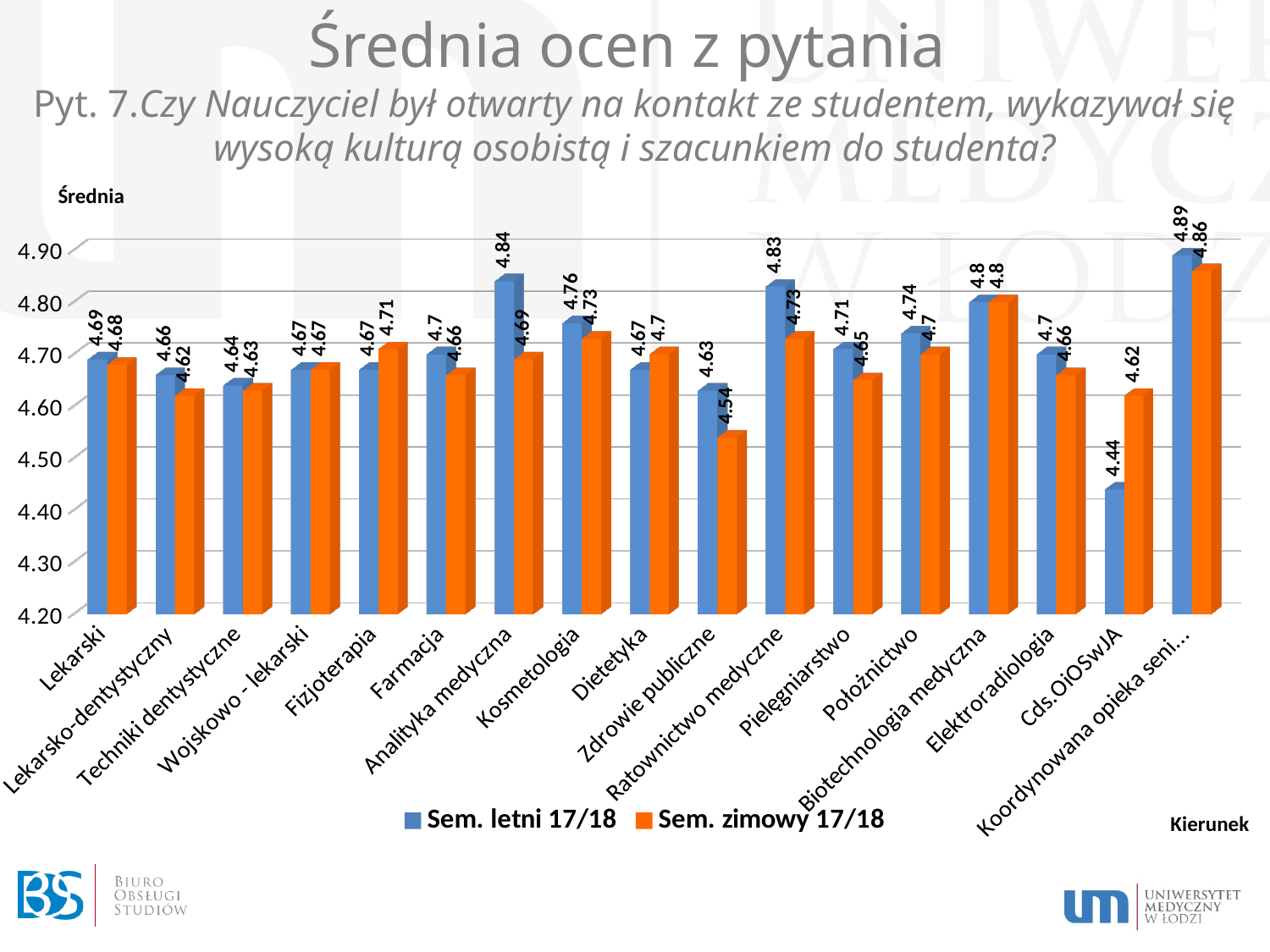
How many series does the legend list? 2 What kind of chart is shown on the slide? Bar chart For Cds.OiOSwJA, which is larger: the Sem. letni 17/18 value or the Sem. zimowy 17/18 value? Sem. zimowy 17/18 Which category has the lowest Sem. zimowy 17/18 value? Zdrowie publiczne What is the Sem. zimowy 17/18 value for Cds.OiOSwJA? 4.62 What is the difference between the Sem. letni 17/18 and Sem. zimowy 17/18 values for Ratownictwo medyczne? 0.1 What is the difference between the Sem. letni 17/18 and Sem. zimowy 17/18 values for Analityka medyczna? 0.15 What is the Sem. zimowy 17/18 value for Zdrowie publiczne? 4.54 How many categories are shown on the x axis? 17 Which category has the highest Sem. letni 17/18 value? Koordynowana opieka seni... What is the Sem. letni 17/18 value for Analityka medyczna? 4.84 Which category has the lowest Sem. letni 17/18 value? Cds.OiOSwJA